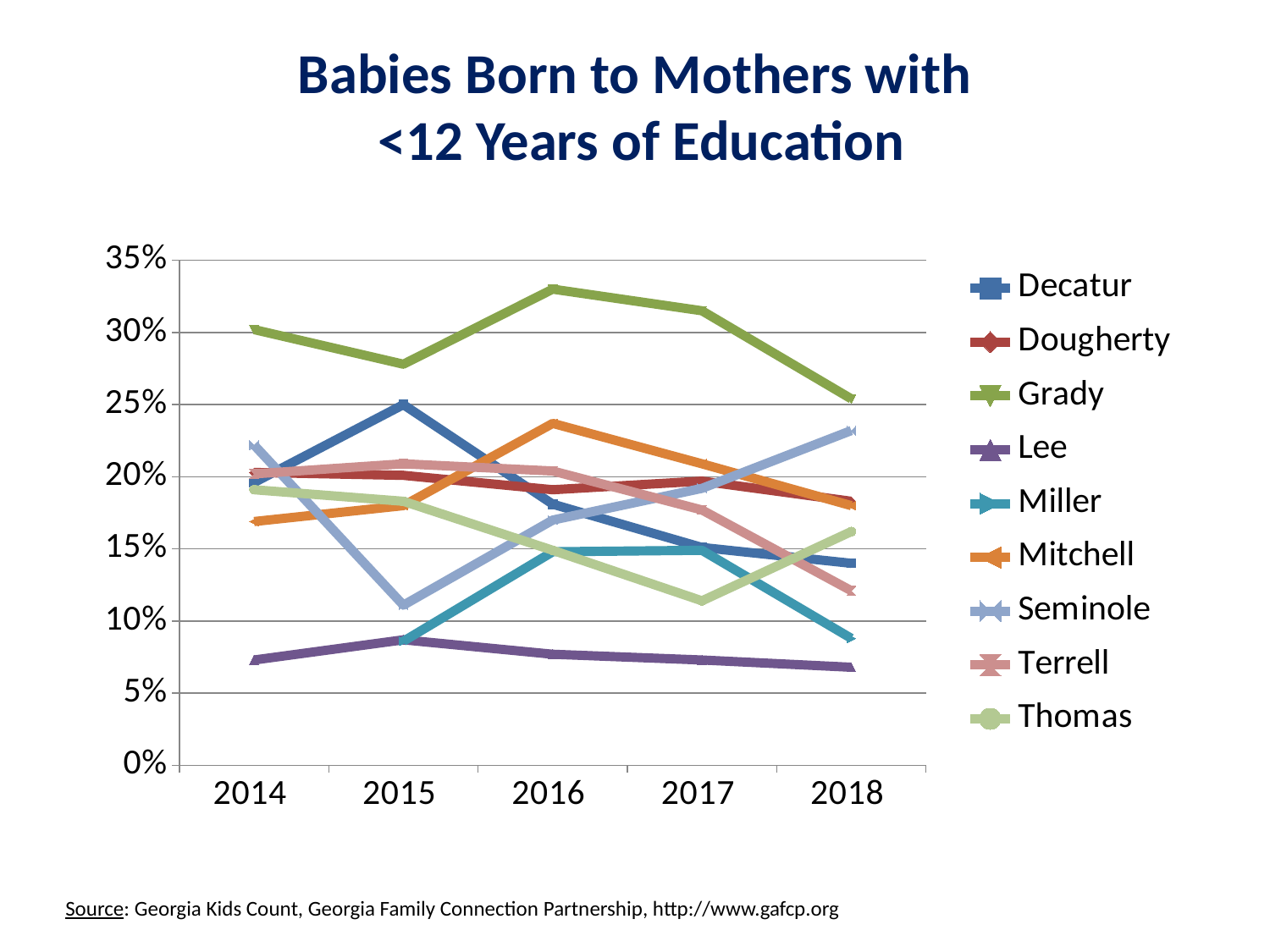
What is the title of the chart? Babies Born to Mothers with <12 Years of Education Does the value for Grady rise or fall from 2017 to 2018? fall Which county has the lowest value in 2018? Lee Does the value for Lee rise or fall from 2015 to 2018? fall Which county has the highest value in 2016? Grady In 2015, which is larger: the value for Decatur or the value for Seminole? Decatur Is the value for Lee in 2014 greater or less than 10%? less How many series does the legend list? 9 How many years are shown on the x axis? 5 What kind of chart is shown on the slide? line chart Is the value for Seminole in 2015 greater or less than 15%? less Is the value for Grady in 2016 greater or less than 30%? greater